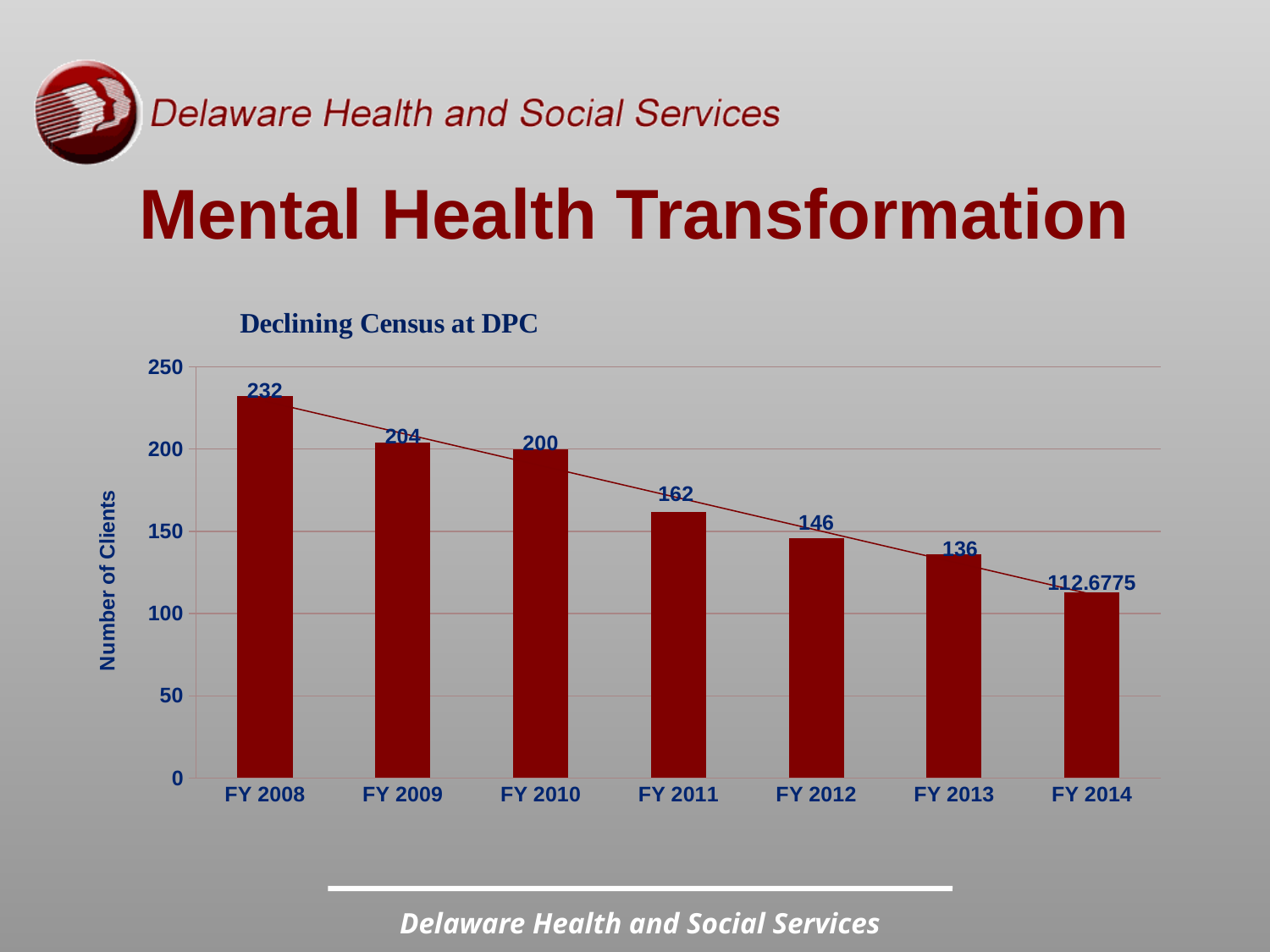
What is the difference in number of clients between FY 2008 and FY 2013? 96 Which fiscal year has the highest number of clients? FY 2008 What is the number of clients for FY 2008? 232 Which has more clients, FY 2009 or FY 2011? FY 2009 How many fiscal years are shown on the x axis? 7 Which fiscal year has the lowest number of clients? FY 2014 What is the number of clients for FY 2014? 112.6775 What is the difference in number of clients between FY 2010 and FY 2012? 54 What is the number of clients for FY 2011? 162 Do the values rise or fall from FY 2008 to FY 2014? Fall What is the title of the chart? Declining Census at DPC What kind of chart is shown on the slide? Bar chart